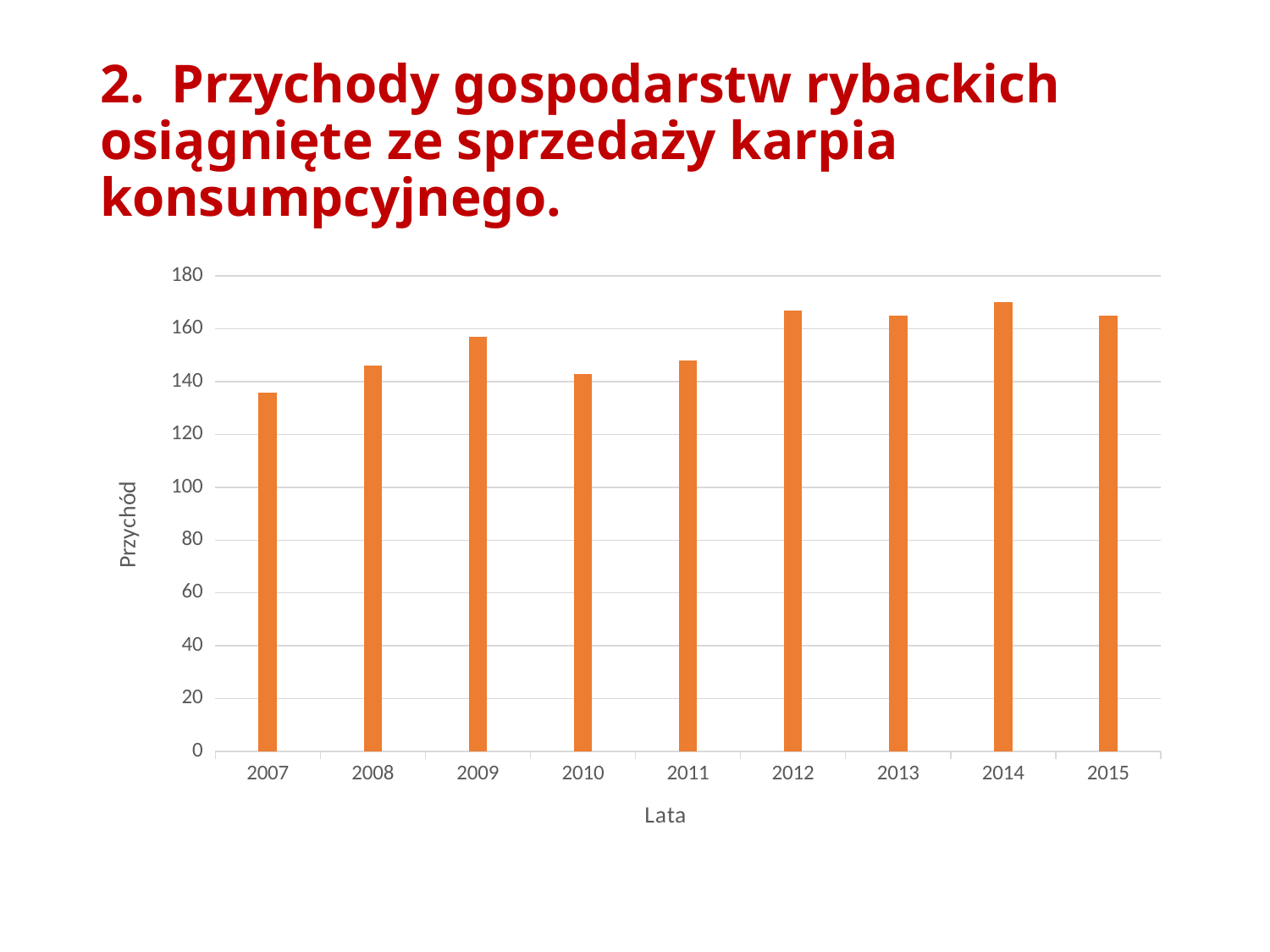
Which year has the larger value, 2011 or 2012? 2012 Is the value for 2009 greater or less than 160? less Is the value for 2007 greater or less than 140? less What kind of chart is shown on the slide? bar chart Overall, do the values rise or fall from 2007 to 2015? rise Which year has the larger value, 2009 or 2010? 2009 What is the title of the x axis of the chart? Lata Is the value for 2011 greater or less than 140? greater Which year has the highest revenue (Przychód) in the chart? 2014 Which year has the lowest revenue (Przychód) in the chart? 2007 How many years are shown on the x axis of the chart? 9